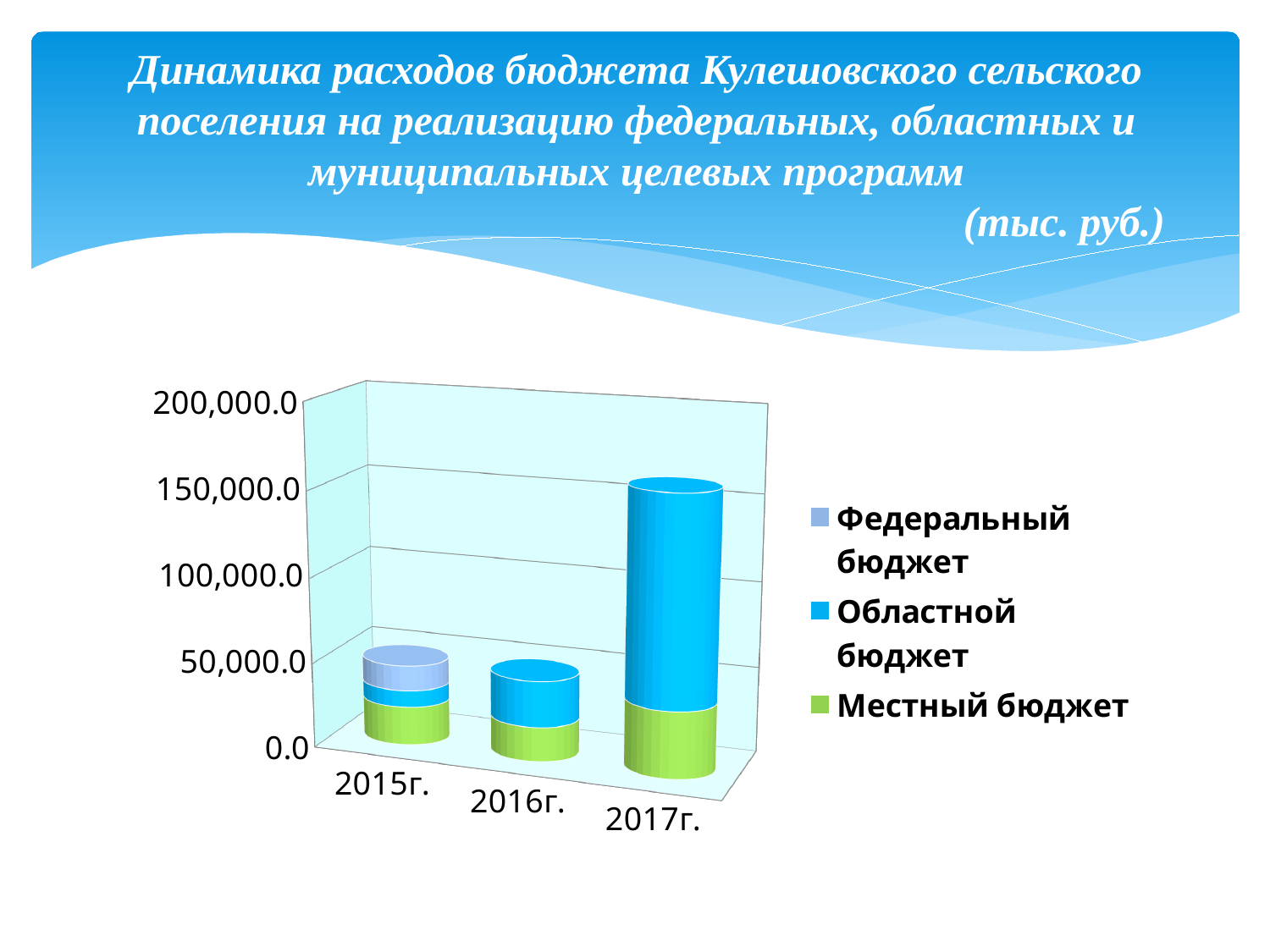
Which total bar is larger, 2017г. or 2015г.? 2017г. Is the total bar for 2017г. greater or less than 100,000.0? greater Which year is the only one with a Федеральный бюджет segment in its bar? 2015г. What kind of chart is shown on the slide? bar chart What unit is given in the chart title for the values? тыс. руб. How many years (categories) are shown on the x axis of the chart? 3 Which year has the highest total bar in the chart? 2017г. How many series does the chart legend list? 3 Does the total bar rise or fall from 2016г. to 2017г.? rise